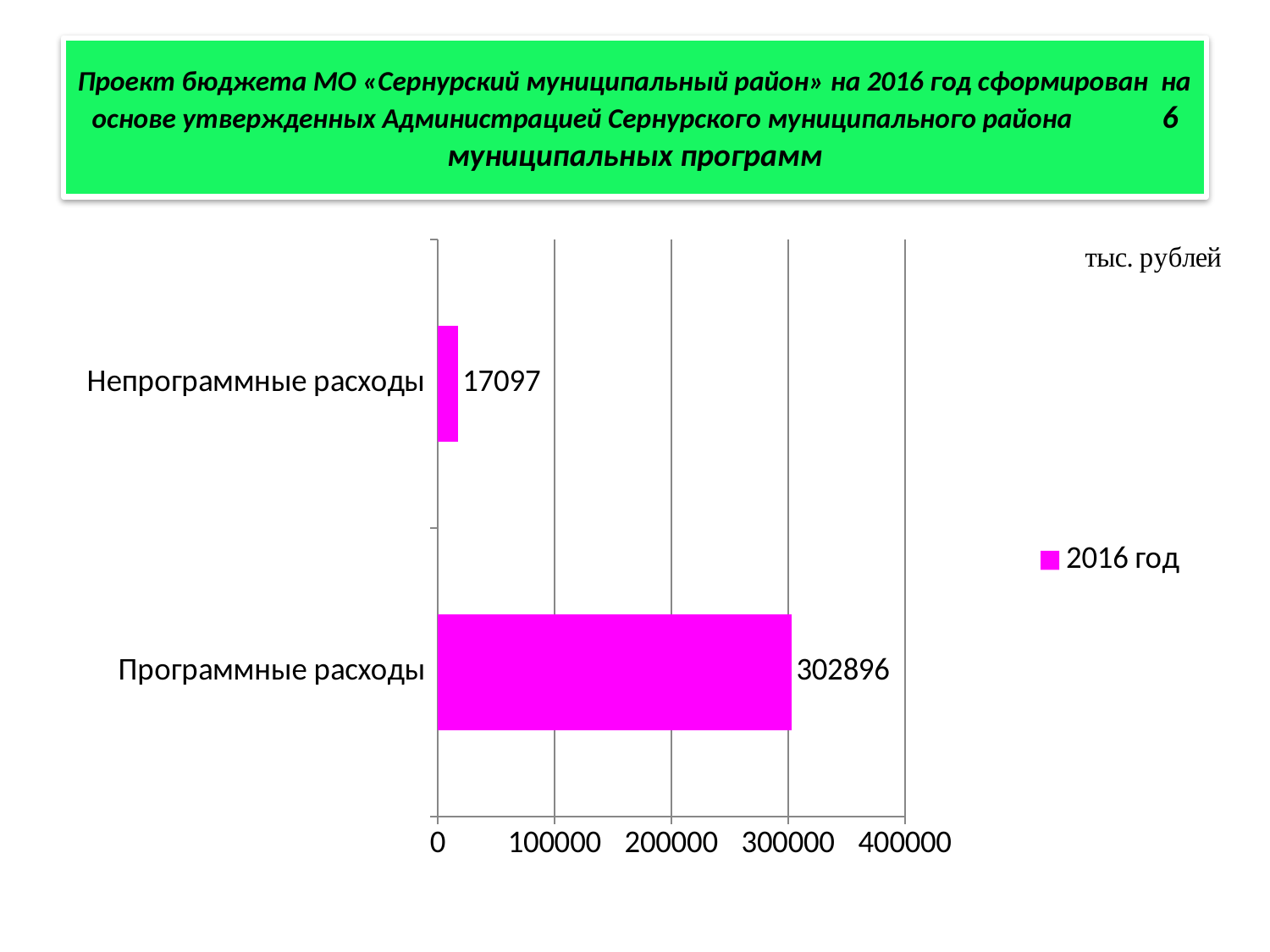
How many categories are shown in the chart? 2 Is the value for Программные расходы greater or less than 300000? greater What is the value for Программные расходы? 302896 Is the value for Непрограммные расходы greater or less than 100000? less What is the value for Непрограммные расходы? 17097 What series name is shown in the legend? 2016 год What is the difference between Программные расходы and Непрограммные расходы? 285799 Which category has the highest value? Программные расходы How many series does the legend list? 1 Which is larger, Программные расходы or Непрограммные расходы? Программные расходы Which category has the lowest value? Непрограммные расходы What kind of chart is shown on the slide? bar chart